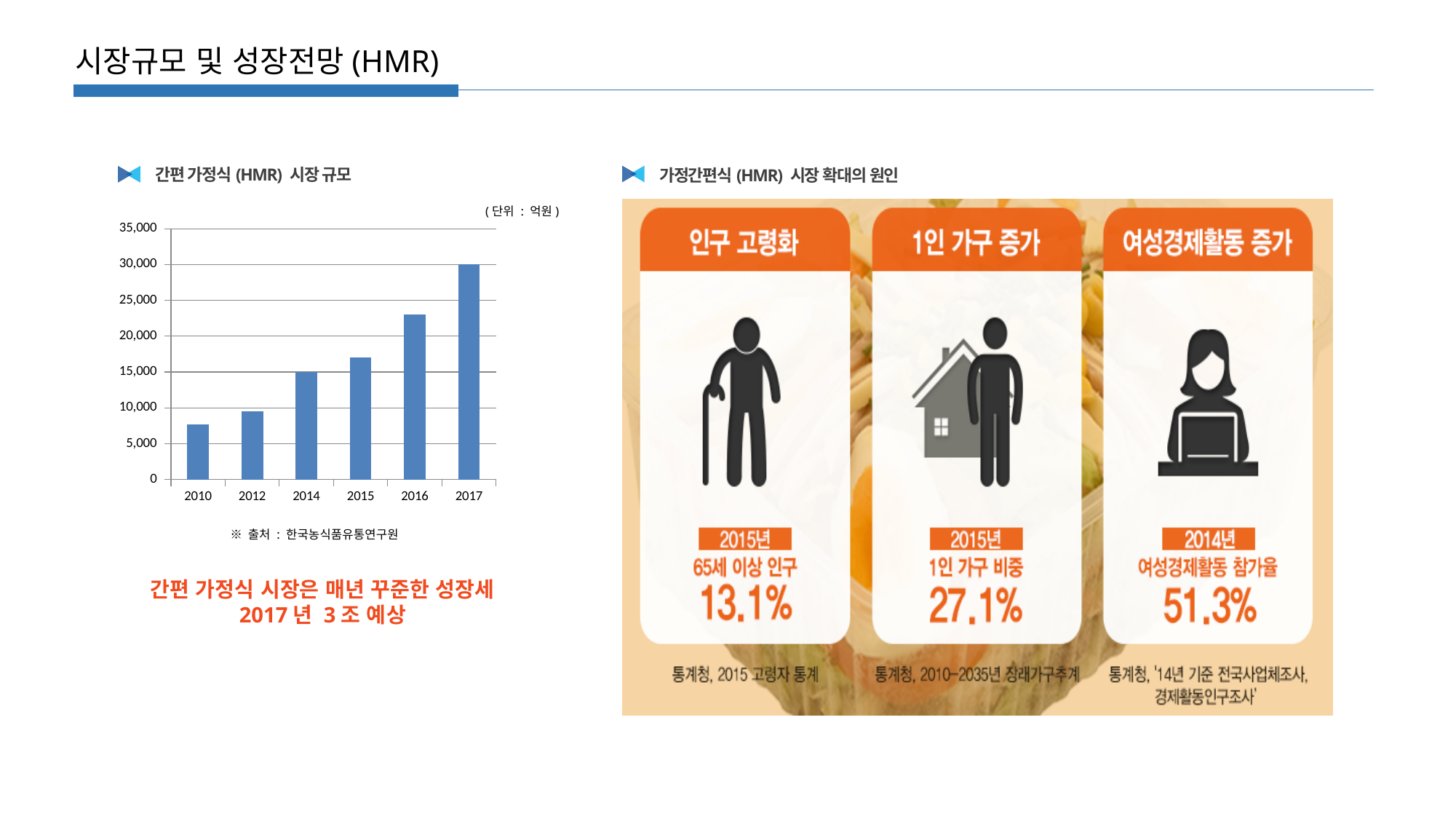
Do the values in the HMR market size chart rise or fall from 2010 to 2017? rise Which year has the lowest value in the HMR market size chart? 2010 Is the value for 2016 in the HMR market size chart greater or less than 20,000? greater Which year has the highest value in the HMR market size chart? 2017 How many years are shown on the x axis of the HMR market size chart? 6 Is the value for 2015 in the HMR market size chart greater or less than 15,000? greater What is the difference between the 2017 and 2014 values in the HMR market size chart? 15,000 What is the value for 2014 in the HMR market size chart? 15,000 What kind of chart is used to show the 간편 가정식 (HMR) 시장 규모? bar chart In the HMR market size chart, which is larger, the value for 2016 or the value for 2015? 2016 Is the value for 2010 in the HMR market size chart greater or less than 10,000? less What is the value for 2017 in the HMR market size chart? 30,000